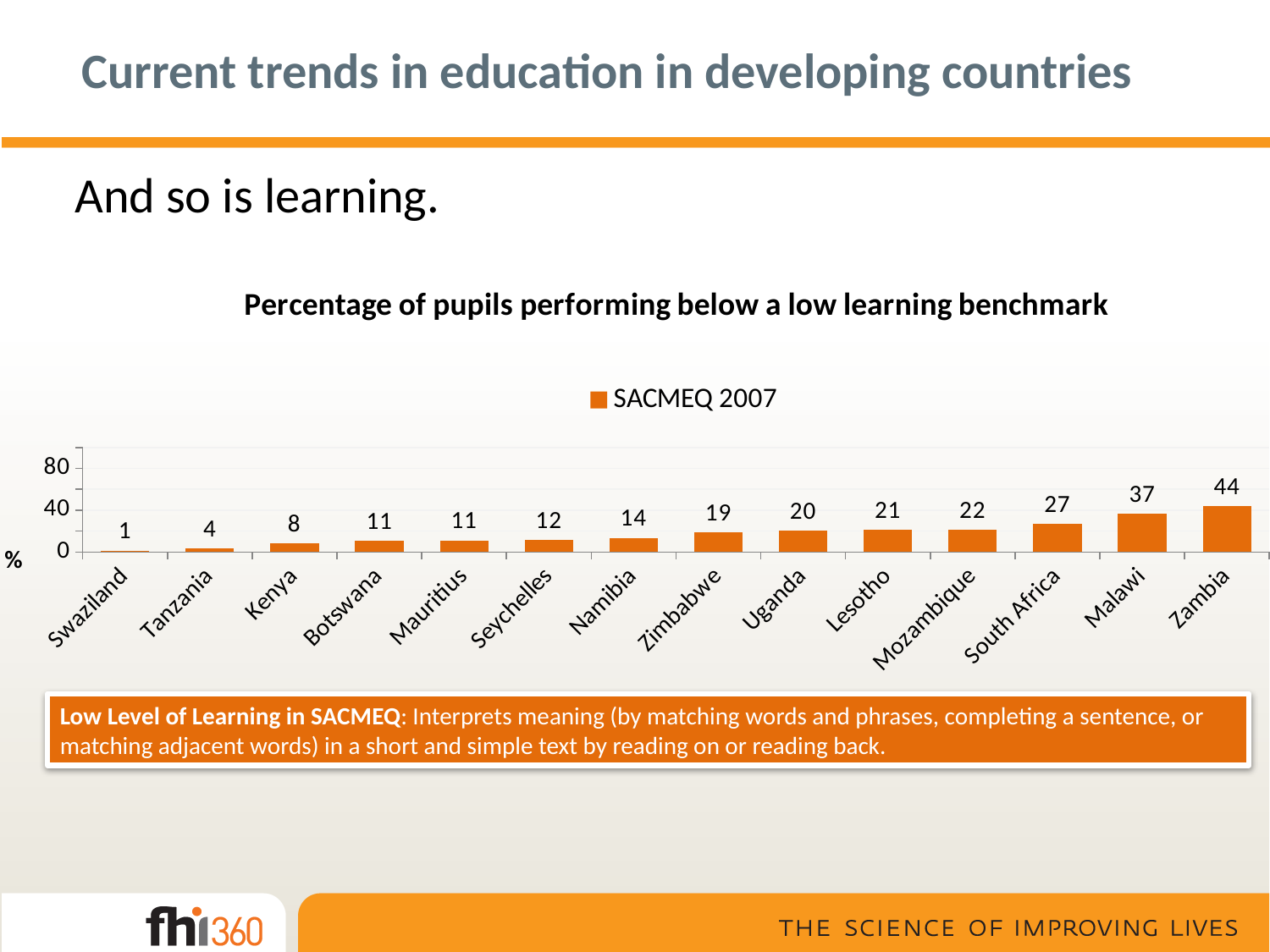
Which country has the highest percentage of pupils performing below the low learning benchmark? Zambia Which country has the lowest percentage of pupils performing below the low learning benchmark? Swaziland How many countries are shown on the chart? 14 How many series does the legend list? 1 What is the value for Zambia? 44 What is the difference between the values for Zambia and Malawi? 7 Which is larger, the value for South Africa or the value for Lesotho? South Africa What is the series name shown in the legend? SACMEQ 2007 What is the value for Mozambique? 22 What is the value for Kenya? 8 What kind of chart is shown on the slide? bar chart Is the value for Malawi greater or less than 40? less